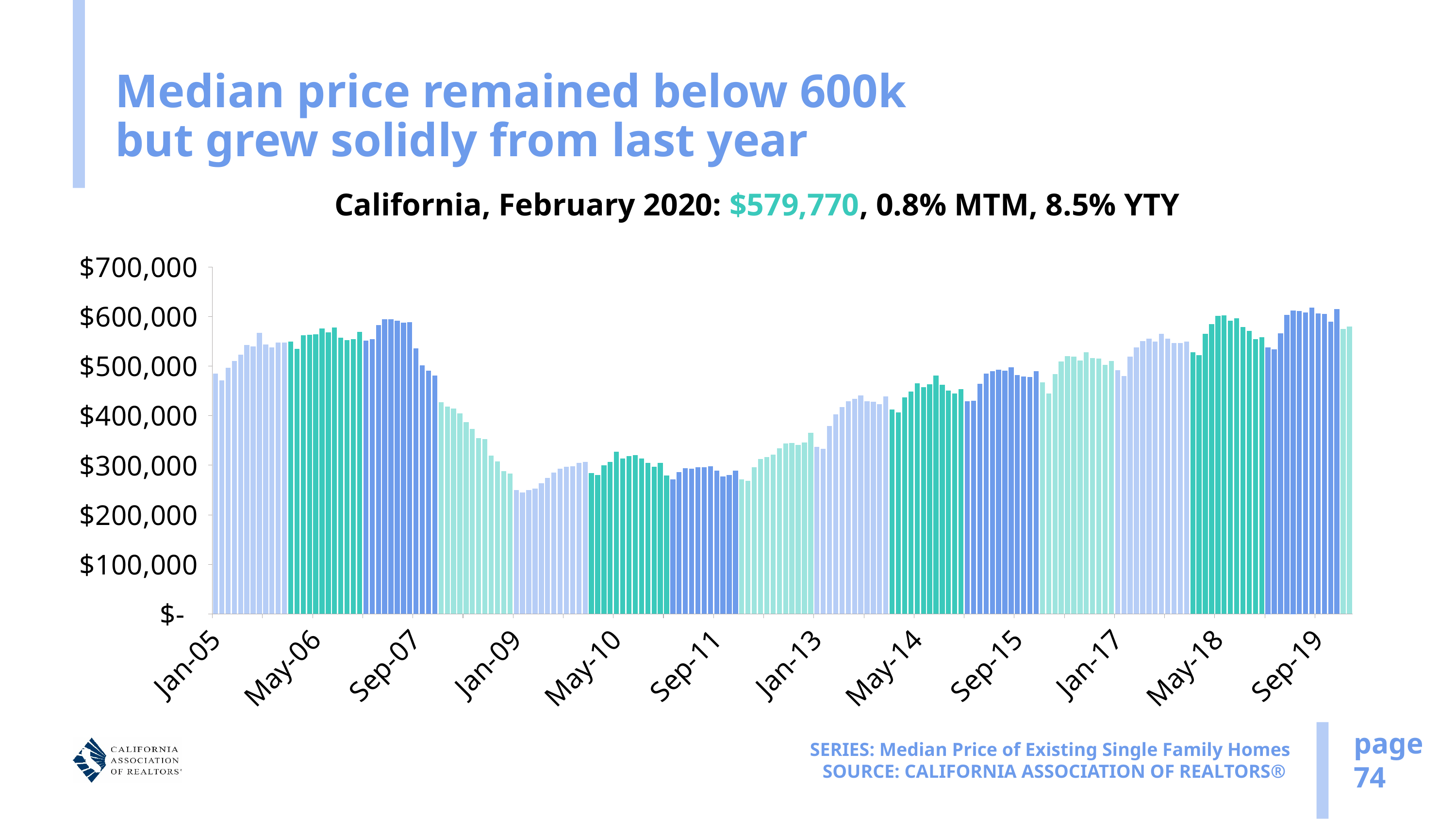
What kind of chart is shown on the slide? bar chart Is the value for Jan-13 greater or less than $400,000? less Is the value for May-10 greater or less than $400,000? less Is the value for Sep-19 greater or less than $500,000? greater Do the values rise or fall between Jan-13 and May-14? rise What series does the chart plot, according to the note at the bottom of the slide? Median Price of Existing Single Family Homes Do the values rise or fall between Sep-07 and Jan-09? fall What is the median price for California in February 2020 shown on the slide? $579,770 What is the month-to-month (MTM) change stated in the chart subtitle? 0.8%